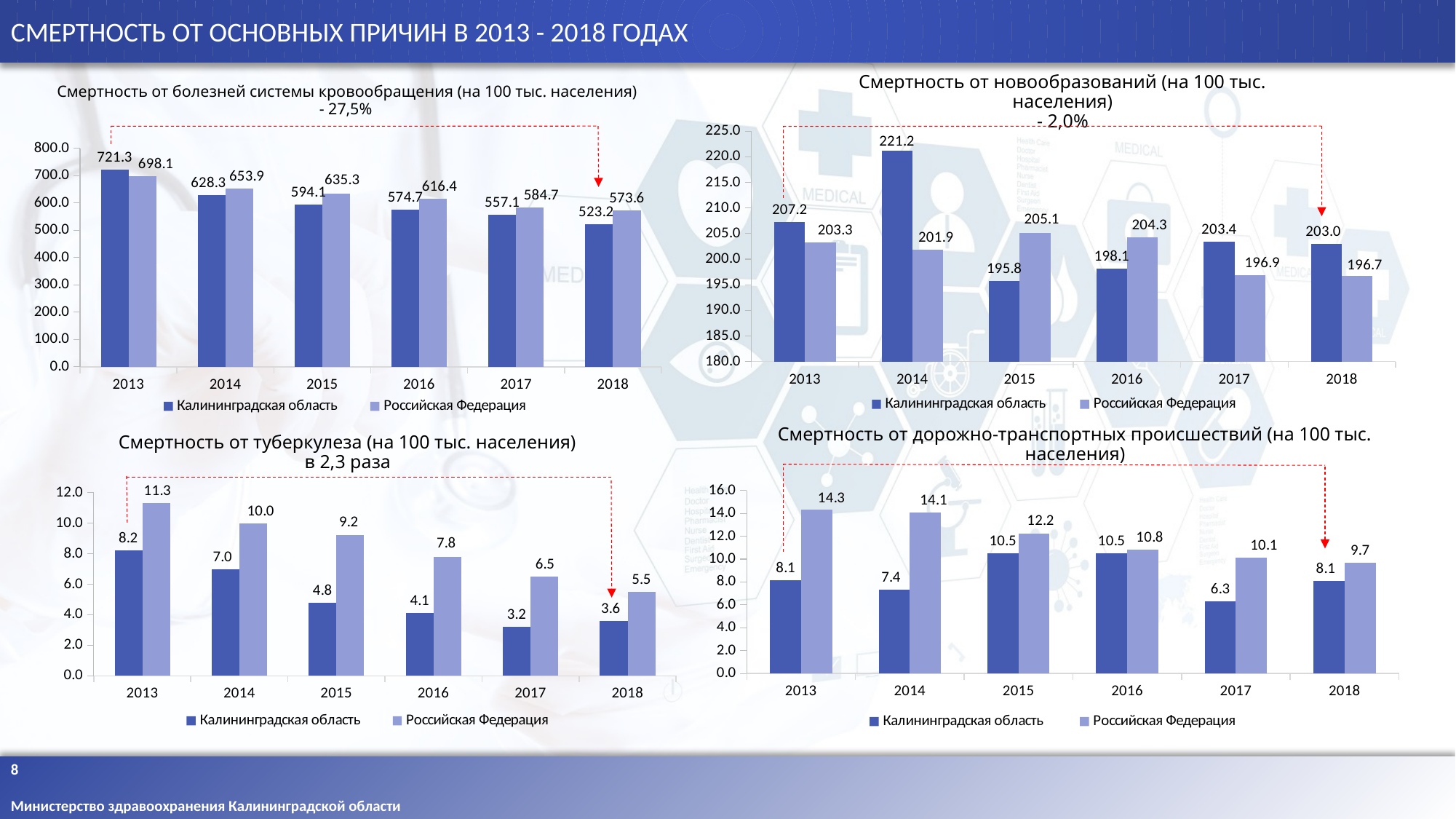
In the top-right chart (Смертность от новообразований), which year has the highest value for Калининградская область? 2014 In the top-left chart (Смертность от болезней системы кровообращения), what is the value for Калининградская область in 2013? 721.3 In the bottom-right chart (Смертность от дорожно-транспортных происшествий), what is the value for Российская Федерация in 2013? 14.3 How many years are shown on the x axis of the bottom-right chart (Смертность от дорожно-транспортных происшествий)? 6 In the top-left chart (Смертность от болезней системы кровообращения), do the Калининградская область values rise or fall from 2013 to 2018? fall In the top-right chart (Смертность от новообразований), what is the value for Российская Федерация in 2017? 196.9 In the top-right chart (Смертность от новообразований), which is larger in 2015: Калининградская область or Российская Федерация? Российская Федерация In the top-left chart (Смертность от болезней системы кровообращения), what is the difference between the Российская Федерация and Калининградская область values in 2018? 50.4 In the bottom-right chart (Смертность от дорожно-транспортных происшествий), what is the difference between the Российская Федерация and Калининградская область values in 2014? 6.7 How many series does the legend of the top-left chart (Смертность от болезней системы кровообращения) list? 2 In the bottom-left chart (Смертность от туберкулеза), which year has the lowest value for Российская Федерация? 2018 In the bottom-left chart (Смертность от туберкулеза), what is the value for Калининградская область in 2017? 3.2